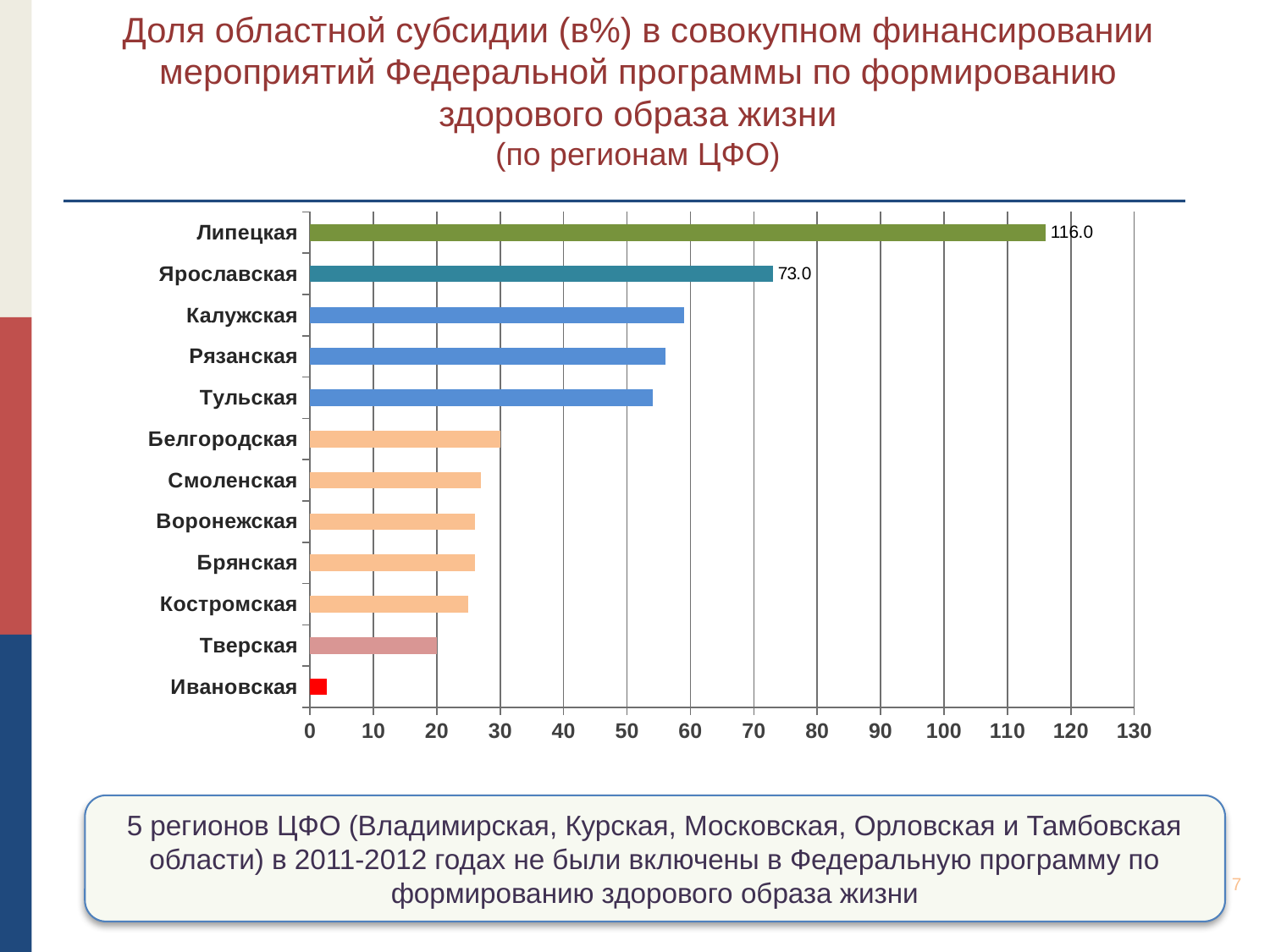
What kind of chart is shown on the slide? bar chart Which region has the lowest value in the chart? Ивановская Which is larger, the value for Калужская or the value for Белгородская? Калужская What is the difference between the values for Липецкая and Ярославская? 43.0 Is the value for Белгородская greater or less than 40? less Which region has the highest value in the chart? Липецкая Is the value for Тверская greater or less than 30? less What is the value shown for Липецкая? 116.0 What is the value shown for Ярославская? 73.0 Is the value for Калужская greater or less than 50? greater How many regions are shown in the chart? 12 What colour is the bar for Ивановская? red